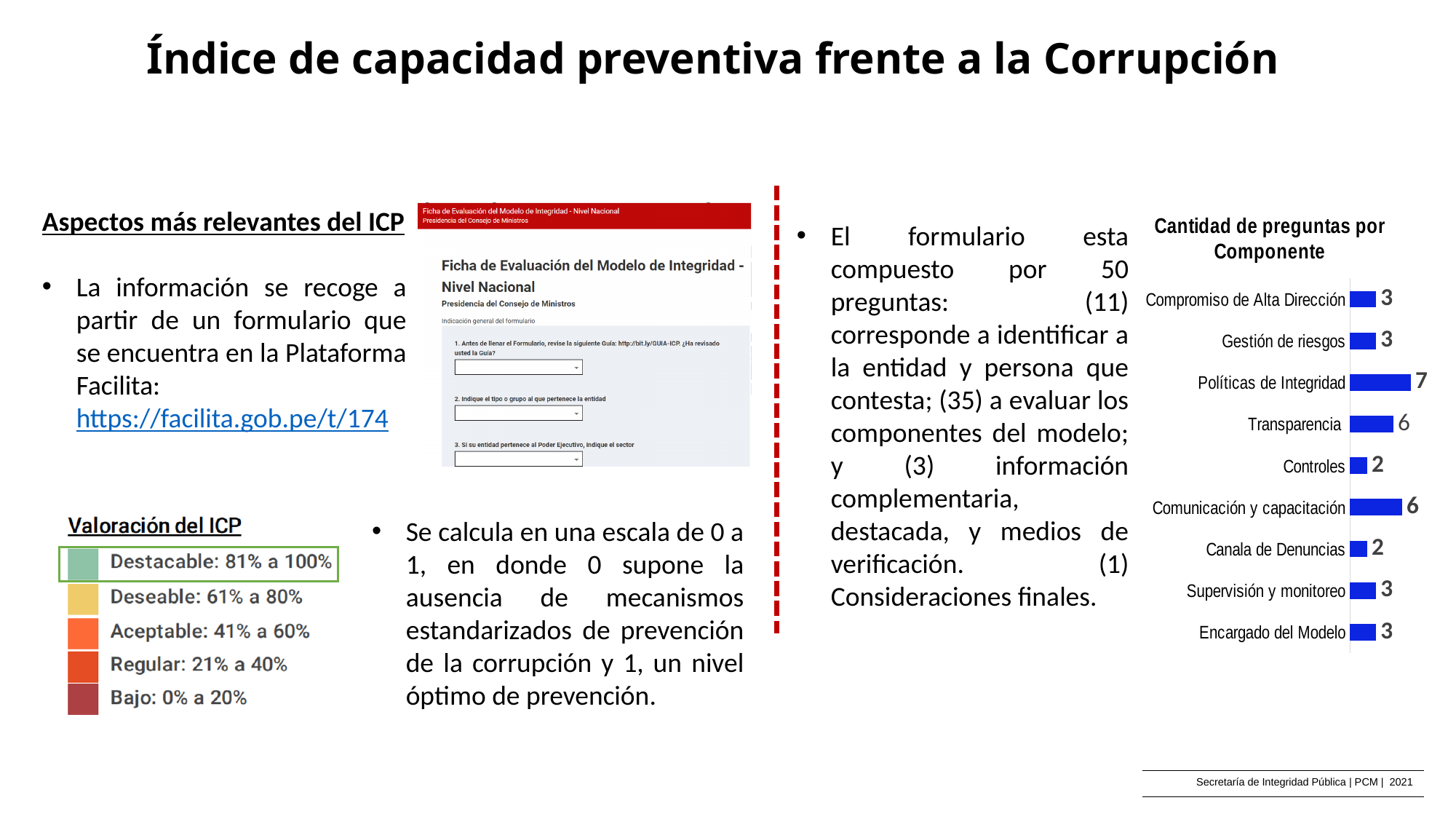
In the chart 'Cantidad de preguntas por Componente', how many questions does Políticas de Integridad have? 7 In the chart 'Cantidad de preguntas por Componente', what is the difference between Políticas de Integridad and Canala de Denuncias? 5 What kind of chart is 'Cantidad de preguntas por Componente'? Bar chart In the chart 'Cantidad de preguntas por Componente', which component has the highest number of questions? Políticas de Integridad What is the title of the chart on the right side of the slide? Cantidad de preguntas por Componente In the chart 'Cantidad de preguntas por Componente', what is the value for Encargado del Modelo? 3 In the chart 'Cantidad de preguntas por Componente', how many components are listed? 9 In the chart 'Cantidad de preguntas por Componente', what is the value for Transparencia? 6 In the chart 'Cantidad de preguntas por Componente', what is the value for Controles? 2 In the chart 'Cantidad de preguntas por Componente', which has more questions, Transparencia or Gestión de riesgos? Transparencia In the chart 'Cantidad de preguntas por Componente', what is the value for Comunicación y capacitación? 6 In the chart 'Cantidad de preguntas por Componente', what is the difference between Comunicación y capacitación and Supervisión y monitoreo? 3